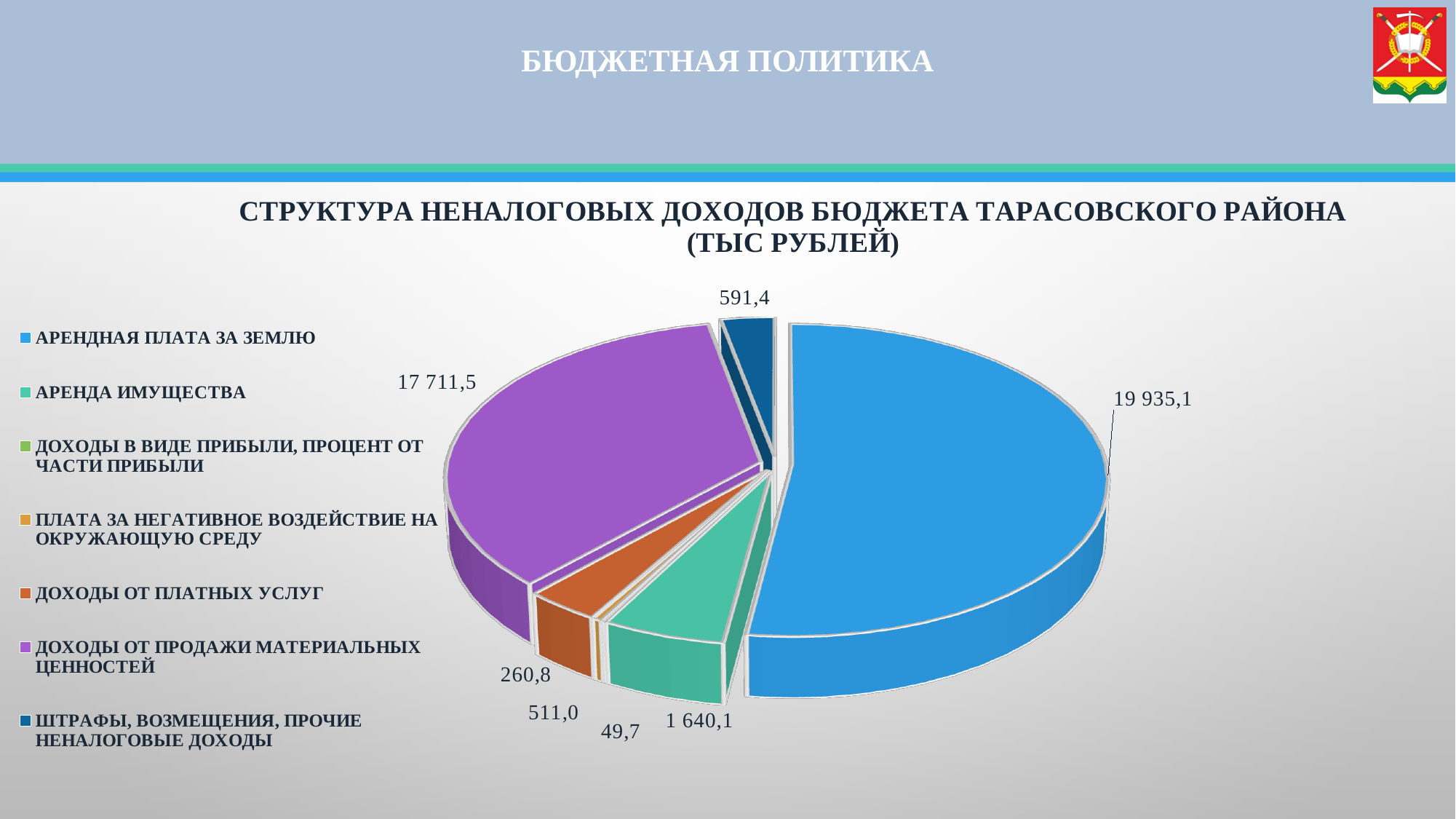
Which category has the largest slice of the pie? АРЕНДНАЯ ПЛАТА ЗА ЗЕМЛЮ What is the value for ДОХОДЫ ОТ ПРОДАЖИ МАТЕРИАЛЬНЫХ ЦЕННОСТЕЙ? 17 711,5 How many categories does the legend of the pie chart list? 7 What is the value for ШТРАФЫ, ВОЗМЕЩЕНИЯ, ПРОЧИЕ НЕНАЛОГОВЫЕ ДОХОДЫ? 591,4 What is the total of all values labelled on the pie chart? 40 699,6 Which is larger: АРЕНДА ИМУЩЕСТВА or ШТРАФЫ, ВОЗМЕЩЕНИЯ, ПРОЧИЕ НЕНАЛОГОВЫЕ ДОХОДЫ? АРЕНДА ИМУЩЕСТВА What is the value for АРЕНДА ИМУЩЕСТВА? 1 640,1 What is the difference between the values for АРЕНДНАЯ ПЛАТА ЗА ЗЕМЛЮ and ДОХОДЫ ОТ ПРОДАЖИ МАТЕРИАЛЬНЫХ ЦЕННОСТЕЙ? 2 223,6 What unit is stated in the chart title? ТЫС РУБЛЕЙ What is the smallest value labelled on the pie chart? 49,7 What kind of chart is shown on the slide? Pie chart What is the value for АРЕНДНАЯ ПЛАТА ЗА ЗЕМЛЮ? 19 935,1